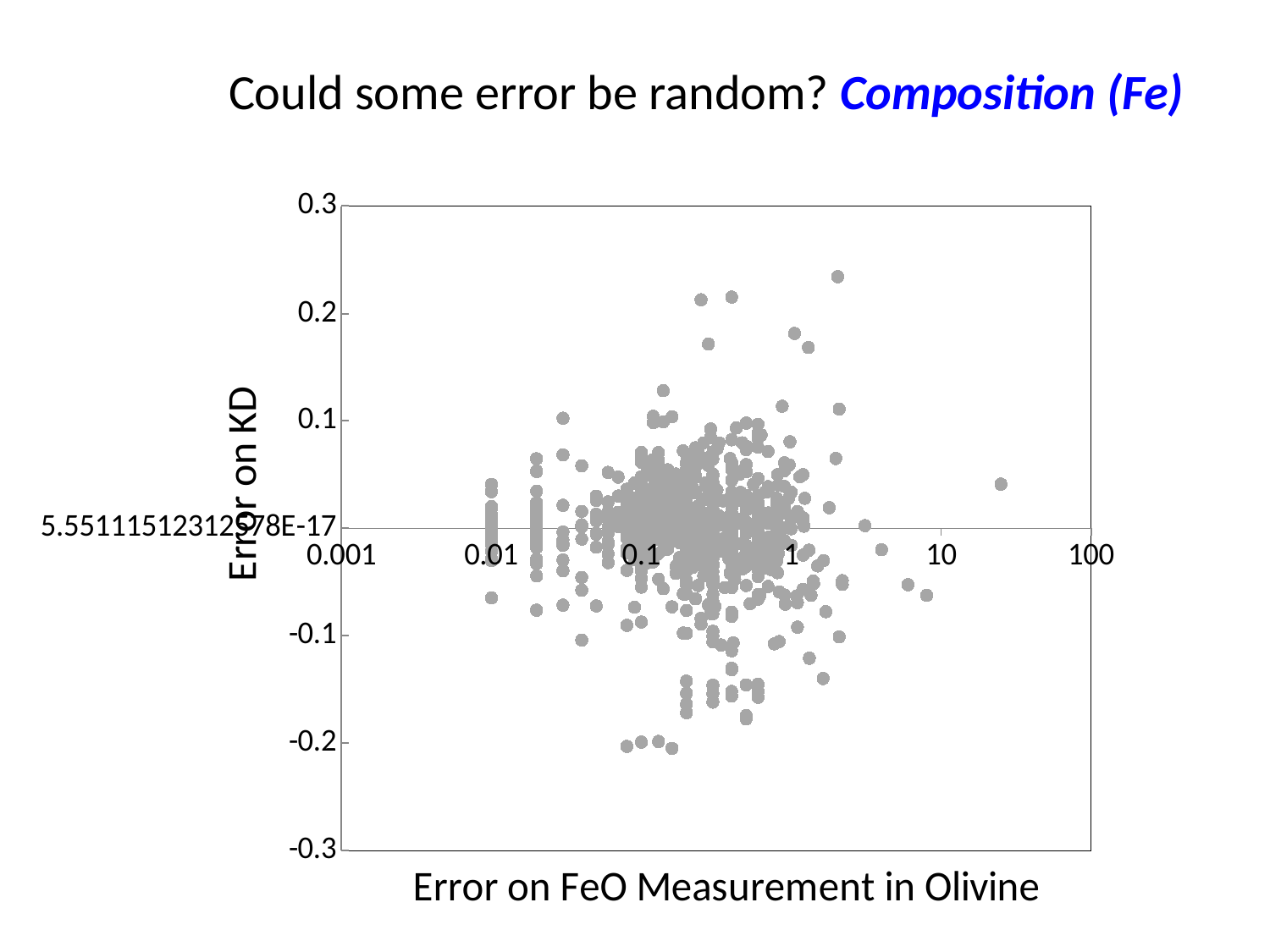
Is the highest plotted Error on KD value greater or less than 0.2? greater What is the title of the horizontal axis of the chart? Error on FeO Measurement in Olivine Is the lowest plotted Error on KD value greater or less than -0.1? less What is the title of the vertical axis of the chart? Error on KD Do the plotted Error on KD values show a clear rising or falling trend as Error on FeO Measurement in Olivine increases? no clear trend Is the highest plotted Error on KD value greater or less than 0.3? less What kind of chart is shown on the slide? scatter chart